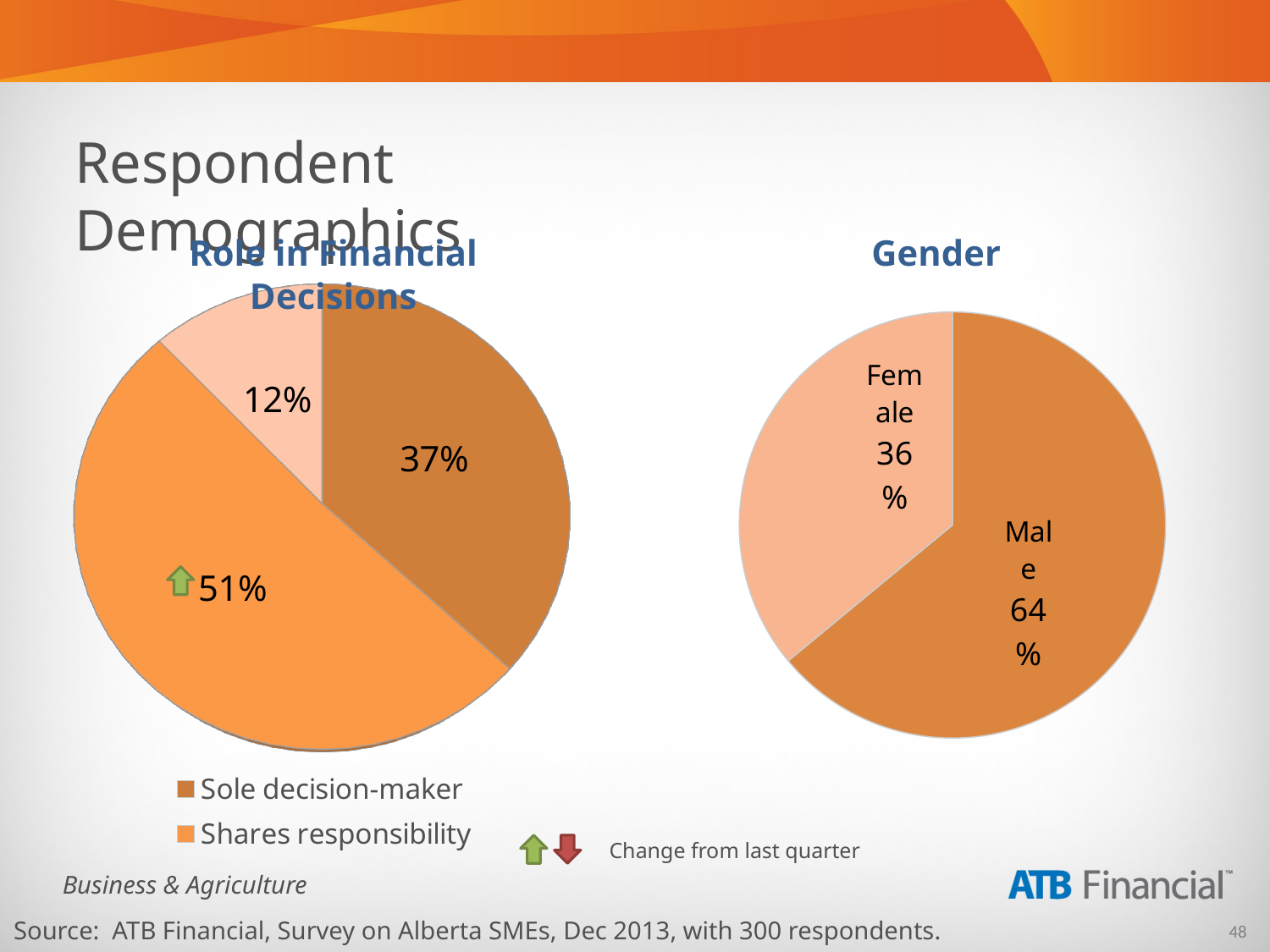
In the Gender chart, what percentage of respondents are male? 64% In the Gender chart, which slice is larger, Male or Female? Male In the Role in Financial Decisions chart, which slice is marked with a green up arrow indicating an increase from last quarter? Shares responsibility (51%) In the Role in Financial Decisions chart, which category has the largest share? Shares responsibility What kind of chart is the Role in Financial Decisions chart? Pie chart How many slices does the Role in Financial Decisions pie chart have? 3 In the Role in Financial Decisions chart, what percentage of respondents share responsibility? 51% In the Role in Financial Decisions chart, what is the smallest slice's value? 12% In the Role in Financial Decisions chart, how many percentage points larger is Shares responsibility than Sole decision-maker? 14 percentage points In the Gender chart, what percentage of respondents are female? 36% In the Gender chart, how many percentage points larger is the Male share than the Female share? 28 percentage points In the Role in Financial Decisions chart, what percentage of respondents are sole decision-makers? 37%